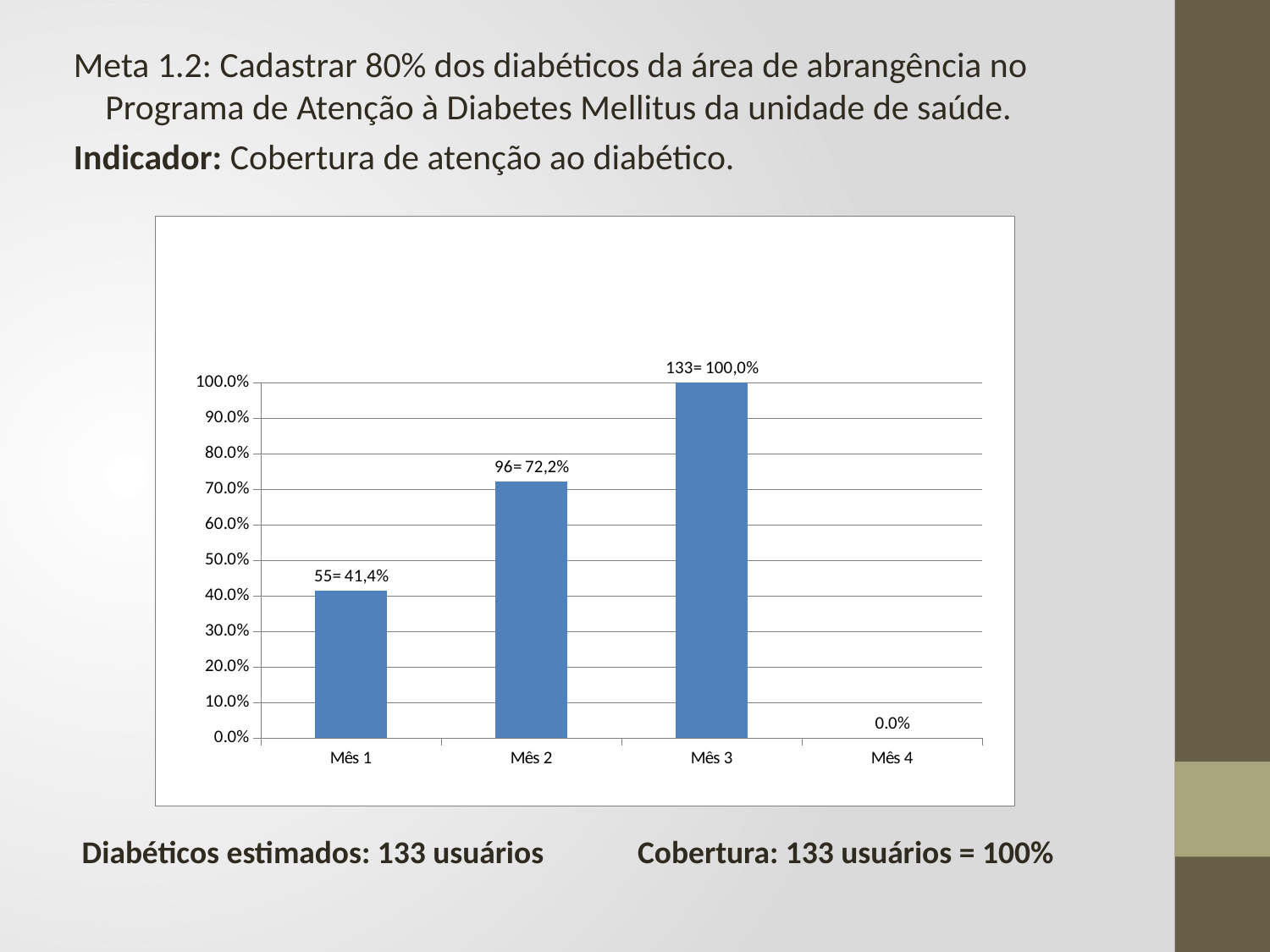
Do the values rise or fall from Mês 1 to Mês 3? rise Which month has the lowest value? Mês 4 Is the value for Mês 2 greater or less than 70.0%? greater What value is shown for Mês 4? 0.0% How many months are shown on the x axis? 4 What is the data label shown for Mês 1? 55= 41,4% What is the data label shown for Mês 3? 133= 100,0% What is the data label shown for Mês 2? 96= 72,2% Is the value for Mês 1 greater or less than 50.0%? less Which is larger, the value for Mês 1 or the value for Mês 2? Mês 2 What kind of chart is shown on the slide? bar chart Which month has the highest bar? Mês 3